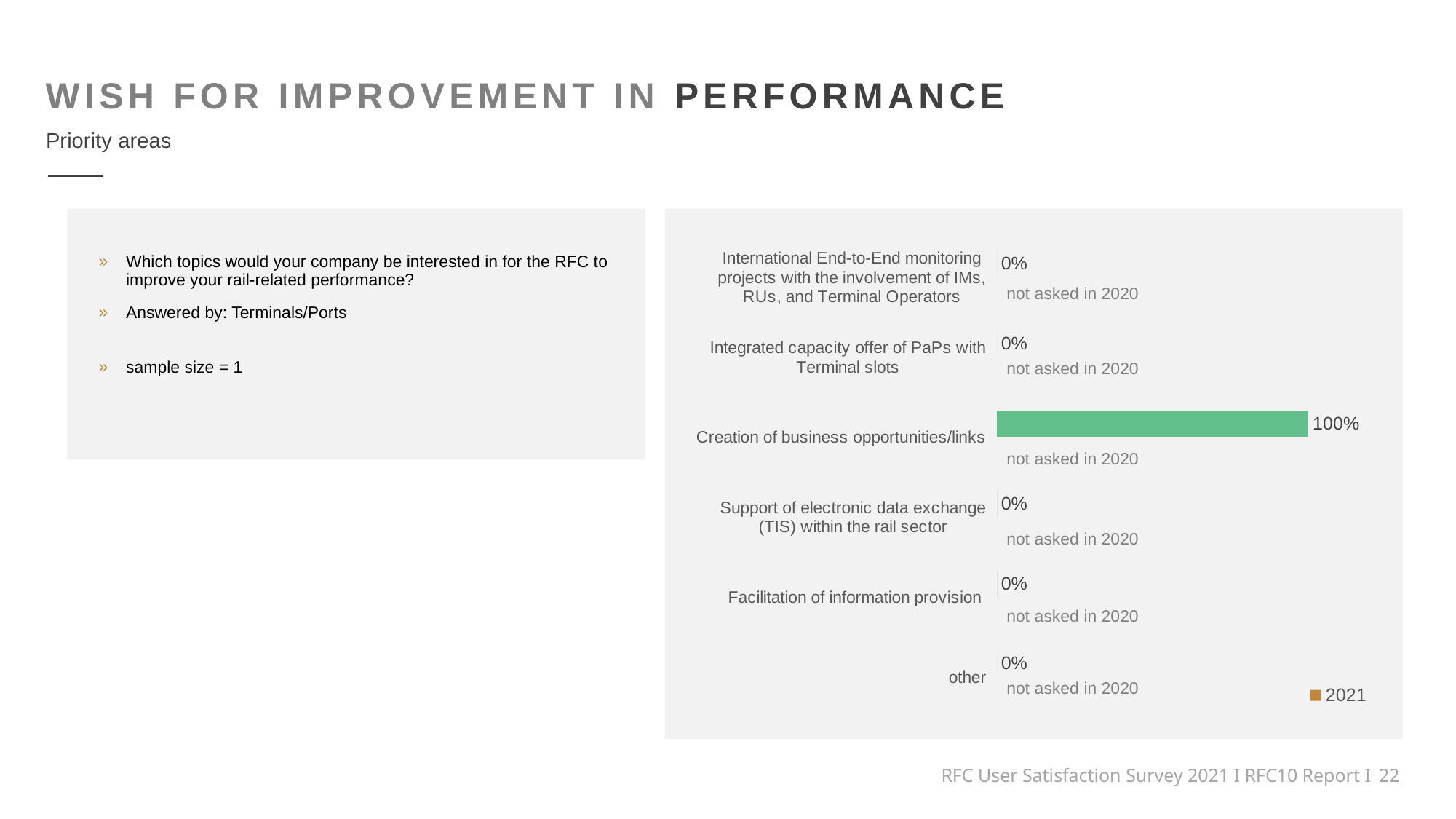
What is the value for Facilitation of information provision in 2021? 0% Which category has the highest value in 2021? Creation of business opportunities/links What is the value for Creation of business opportunities/links in 2021? 100% What note is shown under each category regarding 2020? not asked in 2020 What kind of chart is shown on the slide? Bar chart Which is larger in 2021: Creation of business opportunities/links or Facilitation of information provision? Creation of business opportunities/links How many series does the legend list? 1 What series does the legend list? 2021 What is the value for Support of electronic data exchange (TIS) within the rail sector in 2021? 0% What is the value for Integrated capacity offer of PaPs with Terminal slots in 2021? 0% How many categories are shown in the chart? 6 What is the difference between the values for Creation of business opportunities/links and other in 2021? 100%